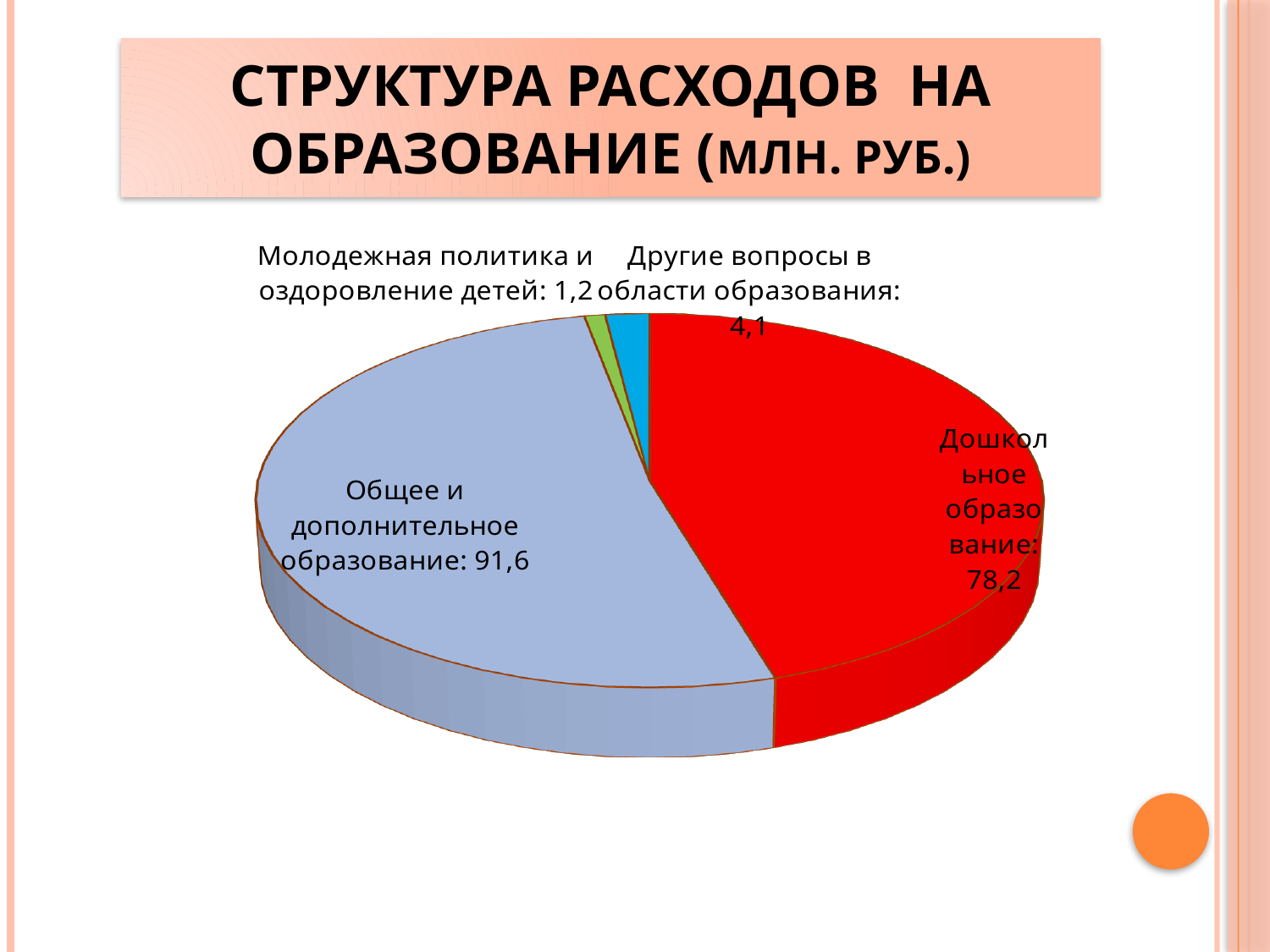
How many slices does the pie chart have? 4 What type of chart is shown on the slide? Pie chart What is the difference between Общее и дополнительное образование and Дошкольное образование? 13,4 Which category has the smallest share of the pie? Молодежная политика и оздоровление детей Which is larger: Дошкольное образование or Другие вопросы в области образования? Дошкольное образование Which category has the largest share of the pie? Общее и дополнительное образование What is the title of the chart on the slide? Структура расходов на образование (млн. руб.) What is the value for Молодежная политика и оздоровление детей? 1,2 What is the value for Дошкольное образование? 78,2 What is the value for Общее и дополнительное образование? 91,6 What is the difference between Другие вопросы в области образования and Молодежная политика и оздоровление детей? 2,9 What is the value for Другие вопросы в области образования? 4,1